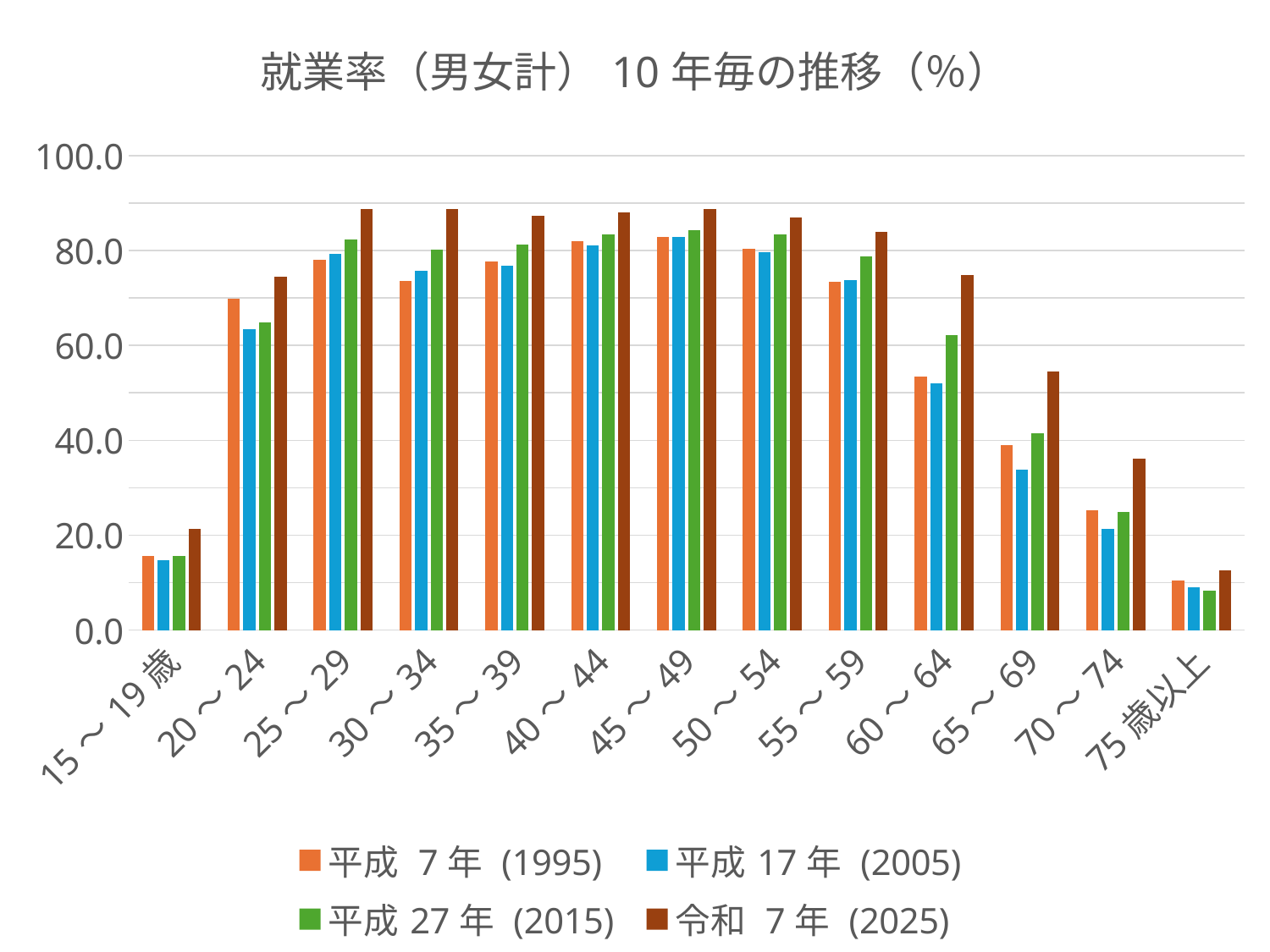
For 令和7年 (2025), do the values rise or fall from the 50～54 age group to the 75歳以上 age group? fall Is the value for 令和7年 (2025) in the 60～64 age group greater or less than 60.0? greater Which series has the highest value in the 60～64 age group? 令和7年 (2025) How many age-group categories are shown on the x axis? 13 Is the value for 令和7年 (2025) in the 75歳以上 age group greater or less than 20.0? less Is the value for 平成7年 (1995) in the 20～24 age group greater or less than 60.0? greater In the 20～24 age group, which is larger: 平成7年 (1995) or 平成17年 (2005)? 平成7年 (1995) What kind of chart is shown on the slide? bar chart Which age group has the lowest value for 令和7年 (2025)? 75歳以上 What is the title of the chart? 就業率（男女計） 10年毎の推移（%） How many series does the legend list? 4